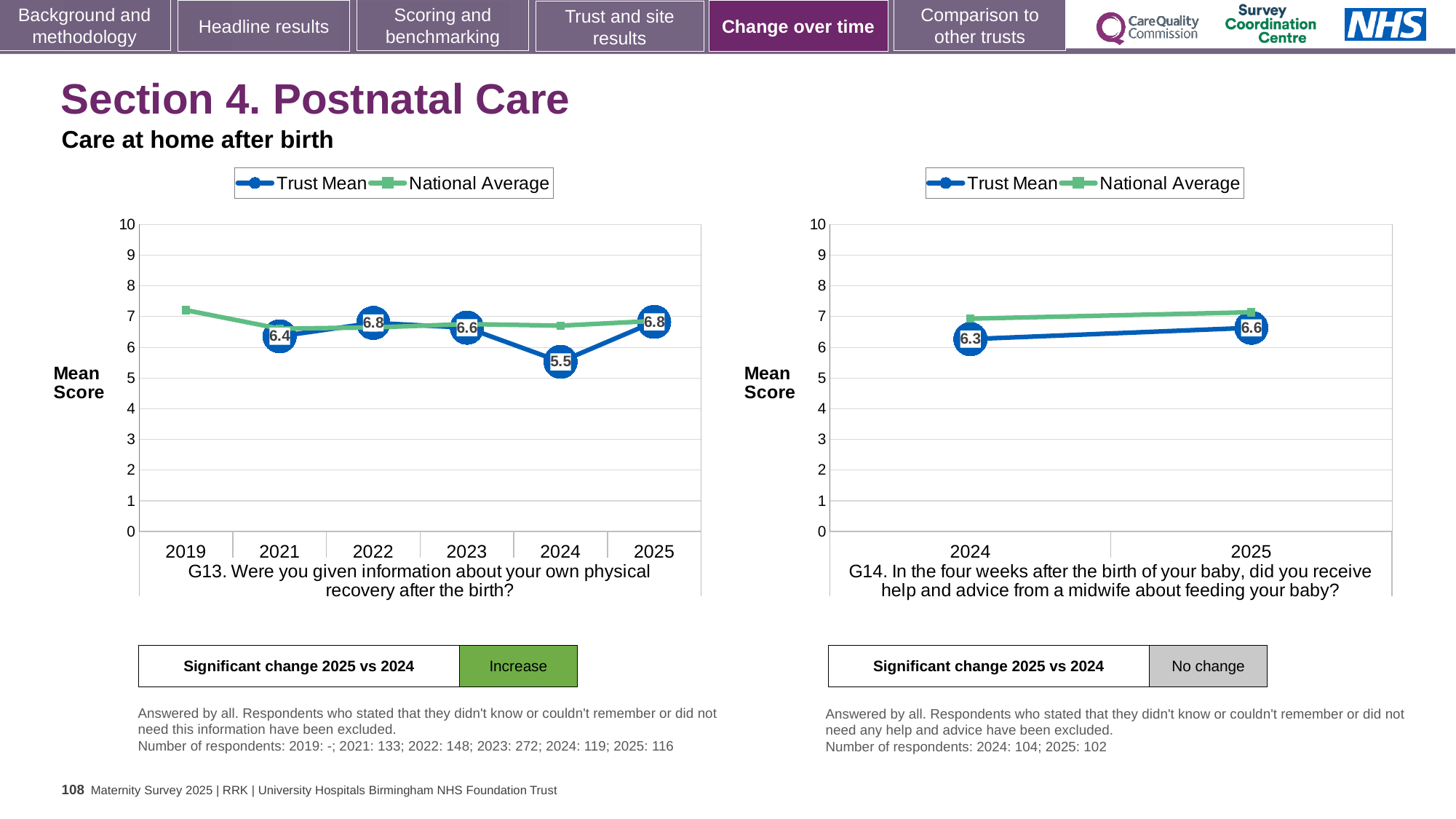
How many years are shown on the x axis of the G13 chart on the left? 6 How many series does the legend of the G14 chart on the right list? 2 What kind of chart is the G14 chart on the right? Line chart What does the 'Significant change 2025 vs 2024' box below the G13 chart on the left say? Increase In the G14 chart on the right, what is the difference between the Trust Mean for 2025 and for 2024? 0.3 In the G13 chart on the left, is the National Average for 2019 greater or less than 7? greater In the G13 chart on the left, what is the Trust Mean for 2024? 5.5 In the G13 chart on the left, is the Trust Mean higher in 2021 or in 2023? 2023 In the G13 chart on the left, what is the difference between the Trust Mean for 2025 and for 2024? 1.3 In the G13 chart on the left, what is the Trust Mean for 2021? 6.4 In the G14 chart on the right, does the Trust Mean rise or fall from 2024 to 2025? Rise In the G13 chart on the left, which year has the lowest Trust Mean? 2024